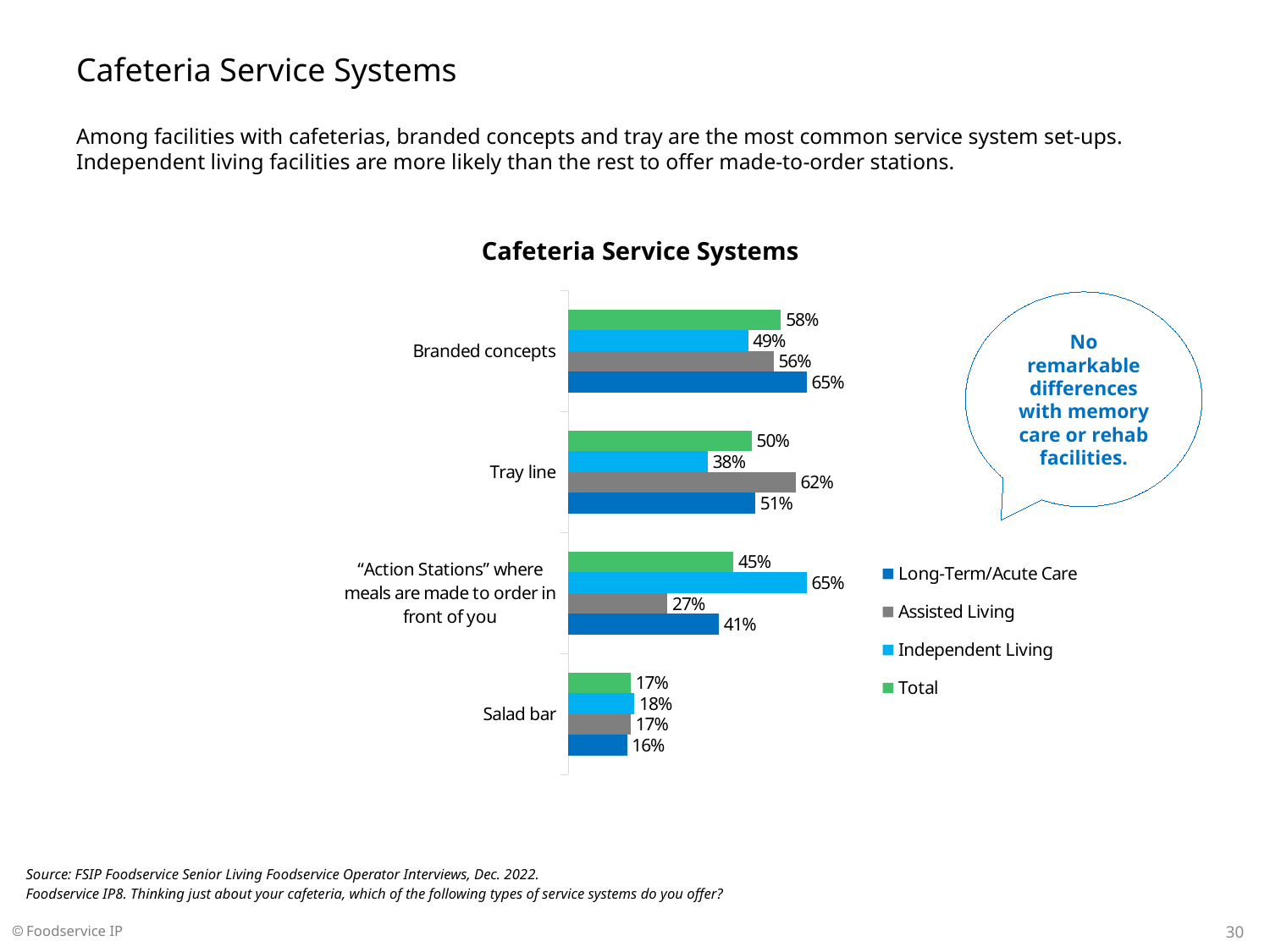
Which category has the highest Total value? Branded concepts What is the Assisted Living value for Tray line? 62% How many categories are shown on the chart? 4 For Tray line, which is larger: the Assisted Living value or the Independent Living value? Assisted Living What is the Total value for Branded concepts? 58% Which category has the lowest Assisted Living value? Salad bar Which series is shown in green in the legend? Total What is the Long-Term/Acute Care value for Salad bar? 16% What is the Independent Living value for "Action Stations" where meals are made to order in front of you? 65% What is the difference between the Long-Term/Acute Care and Independent Living values for Branded concepts? 16% How many series does the legend list? 4 What kind of chart is shown on the slide? Bar chart